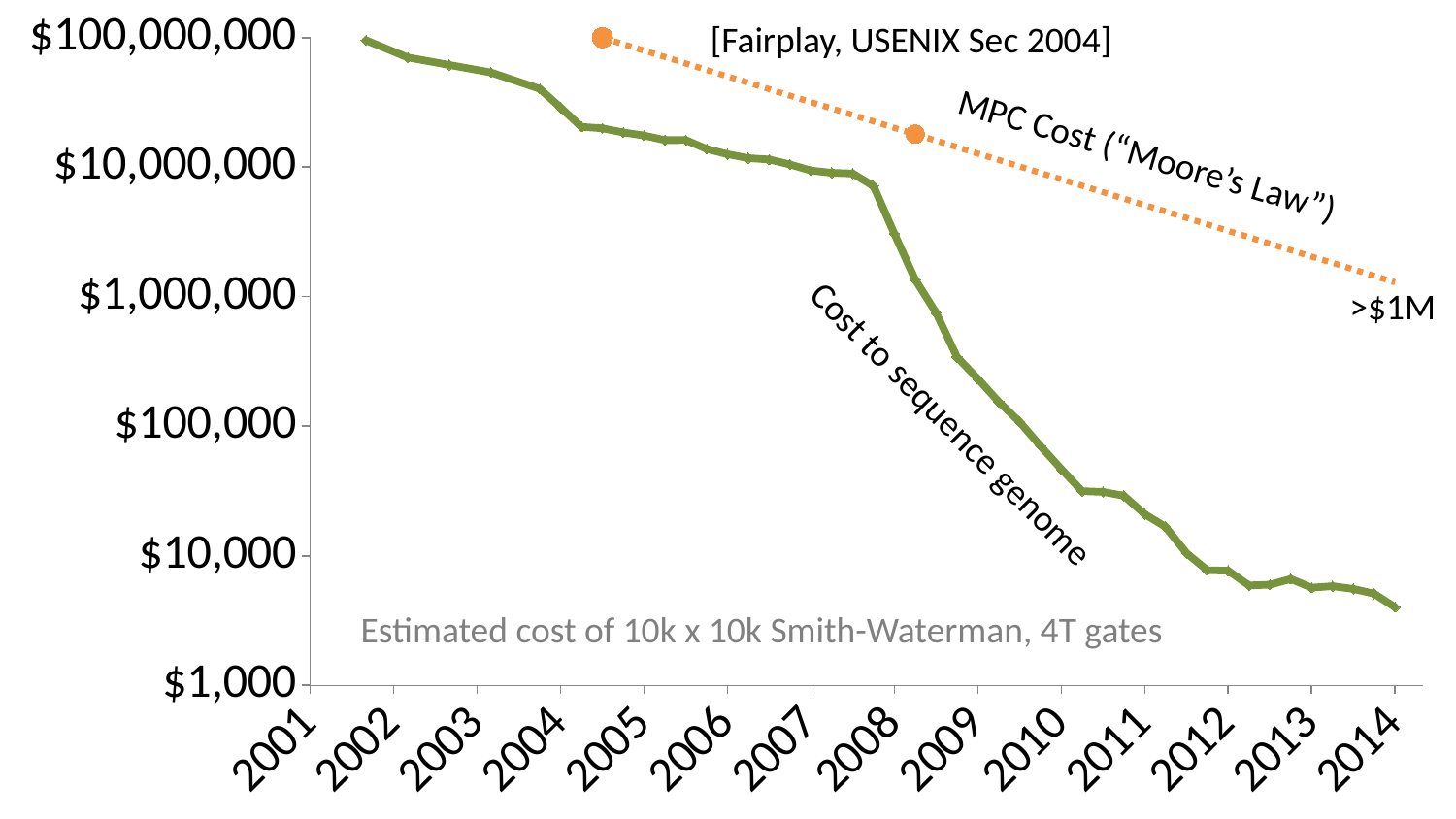
In which year is the 'Cost to sequence genome' line at its lowest? 2014 Is the 'Cost to sequence genome' value in 2014 greater or less than $10,000? less In 2014, which is higher: the 'MPC Cost' line or the 'Cost to sequence genome' line? MPC Cost What citation is written next to the first orange point on the MPC Cost line? [Fairplay, USENIX Sec 2004] Is the 'Cost to sequence genome' value in 2010 greater or less than $100,000? less How many year labels are shown on the x axis? 14 Does the 'MPC Cost ("Moore's Law")' line rise or fall across the years shown? fall In which year is the 'Cost to sequence genome' line at its highest? 2001 What kind of chart is shown on the slide? line chart What is the grey caption text at the bottom of the chart? Estimated cost of 10k x 10k Smith-Waterman, 4T gates Is the 'Cost to sequence genome' value in 2002 greater or less than $10,000,000? greater Does the 'Cost to sequence genome' line rise or fall from 2001 to 2014? fall